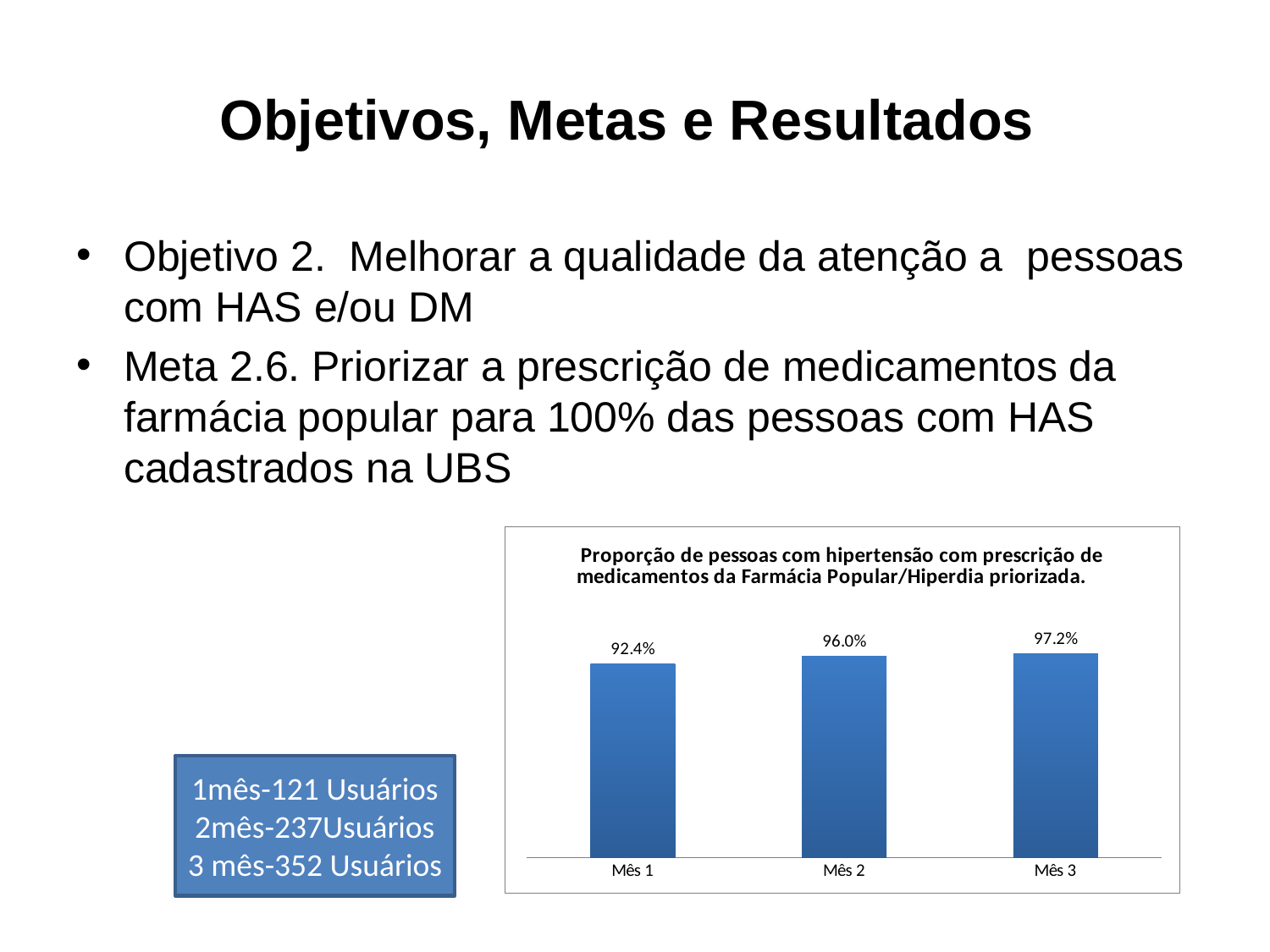
What is the value for Mês 3? 97.2% Which month has the lowest value? Mês 1 Which is larger, the value for Mês 1 or the value for Mês 2? Mês 2 What is the title of the chart? Proporção de pessoas com hipertensão com prescrição de medicamentos da Farmácia Popular/Hiperdia priorizada. What kind of chart is shown on the slide? Bar chart What is the value for Mês 1? 92.4% What is the value for Mês 2? 96.0% How many months are shown on the x axis? 3 What is the difference between the values for Mês 2 and Mês 1? 3.6% What is the difference between the values for Mês 3 and Mês 1? 4.8% Which month has the highest value? Mês 3 Do the values rise or fall from Mês 1 to Mês 3? Rise